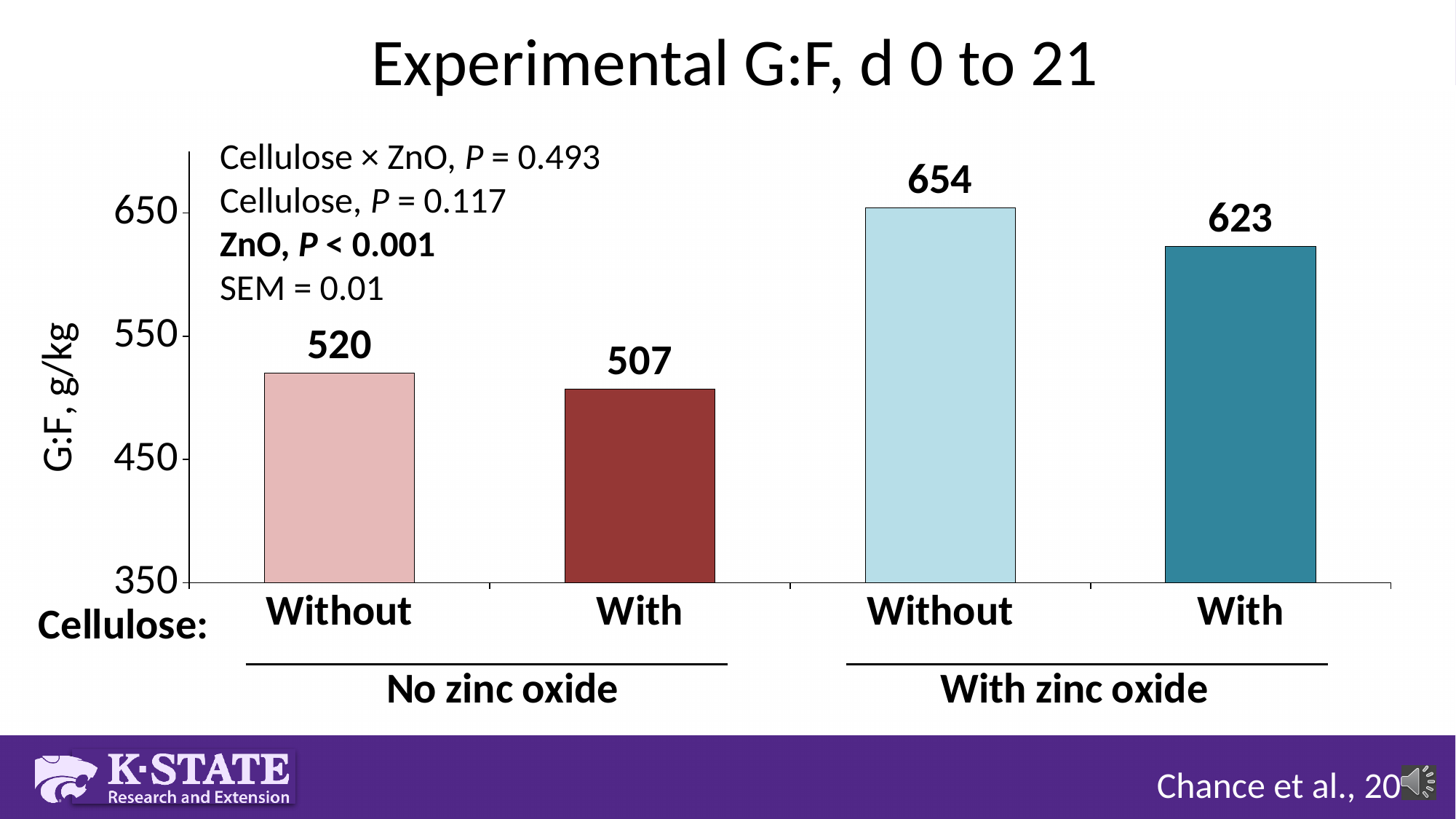
What is the G:F value for the 'With' cellulose bar in the With zinc oxide group? 623 Is the G:F value for 'Without' cellulose in the With zinc oxide group greater or less than 650? greater What type of chart is shown on the slide? Bar chart How many bars are shown in the chart? 4 Which is larger: the G:F for 'With' cellulose with zinc oxide or 'Without' cellulose without zinc oxide? With cellulose, With zinc oxide (623) What is the G:F value for the 'Without' cellulose bar in the No zinc oxide group? 520 What is the G:F value for the 'With' cellulose bar in the No zinc oxide group? 507 What is the title of the chart? Experimental G:F, d 0 to 21 What is the difference in G:F between the 'Without' cellulose bars in the With zinc oxide and No zinc oxide groups? 134 Which bar has the highest G:F value? Without cellulose, With zinc oxide (654) Which bar has the lowest G:F value? With cellulose, No zinc oxide (507) What is the difference in G:F between the 'Without' and 'With' cellulose bars in the With zinc oxide group? 31